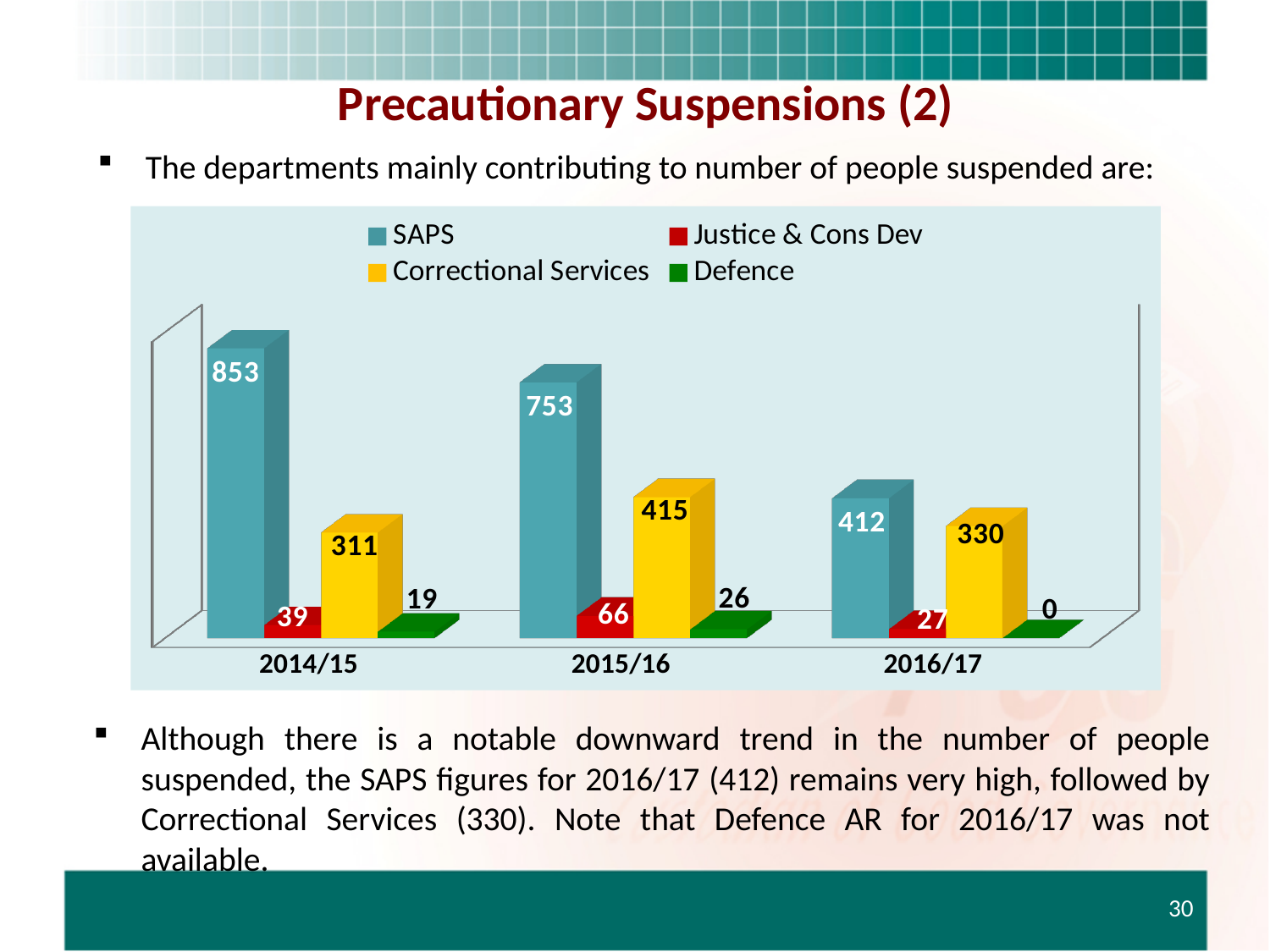
What is the value for Defence in 2016/17? 0 What is the difference between the SAPS values for 2014/15 and 2015/16? 100 What is the value for Justice & Cons Dev in 2016/17? 27 What is the value for Correctional Services in 2015/16? 415 What is the value for SAPS in 2014/15? 853 Which is larger in 2016/17: SAPS or Correctional Services? SAPS In which year is the SAPS value highest? 2014/15 What kind of chart is shown on the slide? Bar chart How many years are shown on the x axis? 3 Do the SAPS values rise or fall from 2014/15 to 2016/17? Fall Which series has the lowest value in 2015/16? Defence How many series does the legend list? 4